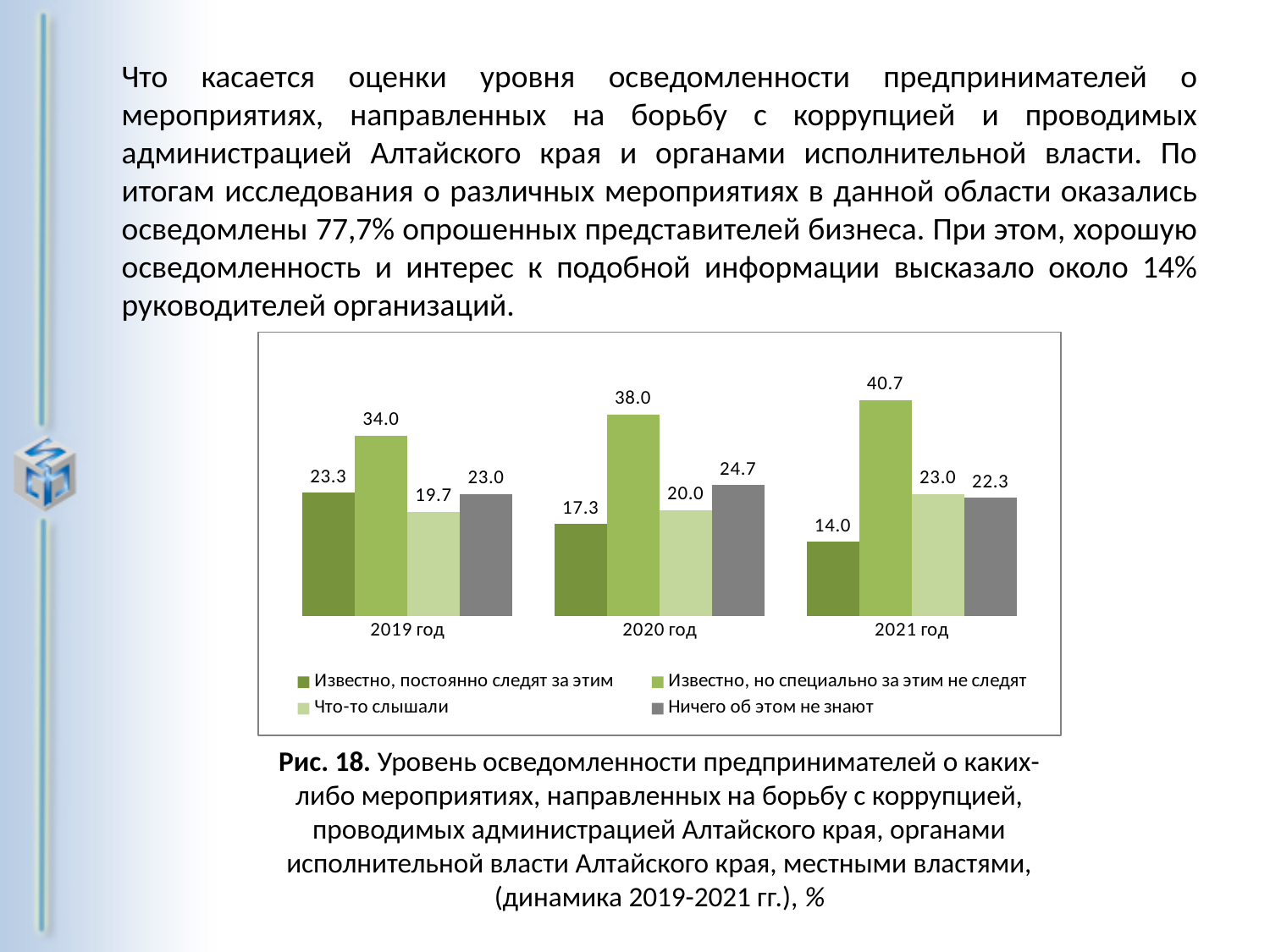
What kind of chart is shown on the slide? Bar chart What is the difference between the "Известно, но специально за этим не следят" values for 2021 год and 2019 год? 6.7 What is the value for "Ничего об этом не знают" in 2020 год? 24.7 Which is larger in 2020 год: "Известно, постоянно следят за этим" or "Что-то слышали"? Что-то слышали In which year is the value for "Известно, но специально за этим не следят" highest? 2021 год In which year is the value for "Известно, постоянно следят за этим" lowest? 2021 год Does the value for "Известно, постоянно следят за этим" rise or fall from 2019 год to 2021 год? Fall What is the value for "Известно, но специально за этим не следят" in 2021 год? 40.7 What is the value for "Известно, постоянно следят за этим" in 2019 год? 23.3 What is the value for "Что-то слышали" in 2019 год? 19.7 How many series does the legend list? 4 How many year categories are shown on the x axis? 3